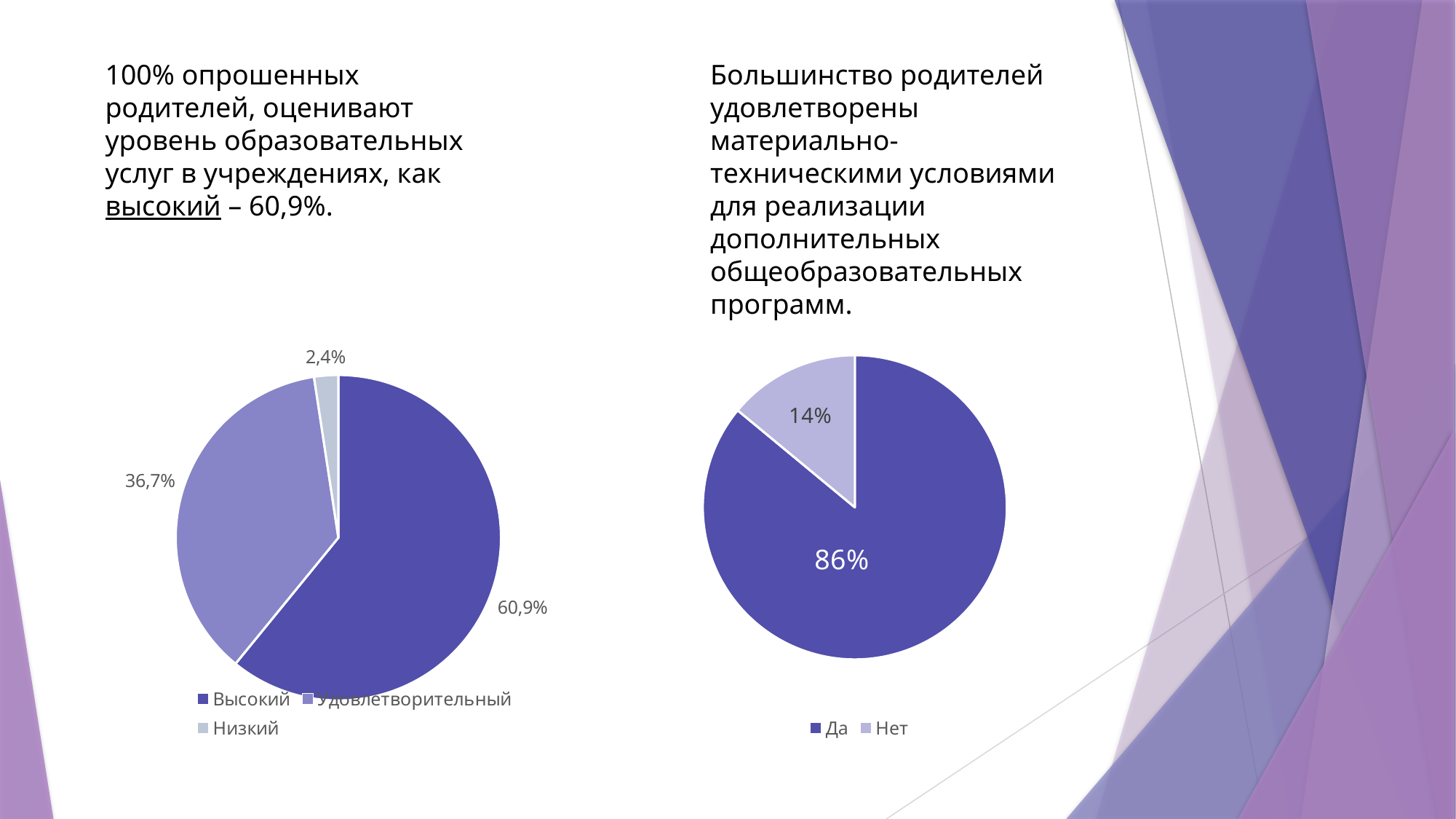
In the left pie chart, which category has the largest slice? Высокий In the right pie chart, what share is labelled for Нет? 14% What type of chart is shown on the right of the slide? Pie chart In the left pie chart, which category has the smallest slice? Низкий In the right pie chart, which is larger, Да or Нет? Да In the right pie chart, what share is labelled for Да? 86% In the right pie chart, how many categories does the legend list? 2 In the left pie chart, what share is labelled for Удовлетворительный? 36,7% In the left pie chart, how many categories does the legend list? 3 In the left pie chart, what is the difference between the Высокий and Удовлетворительный shares? 24,2% In the left pie chart, what share is labelled for Высокий? 60,9% In the left pie chart, what share is labelled for Низкий? 2,4%